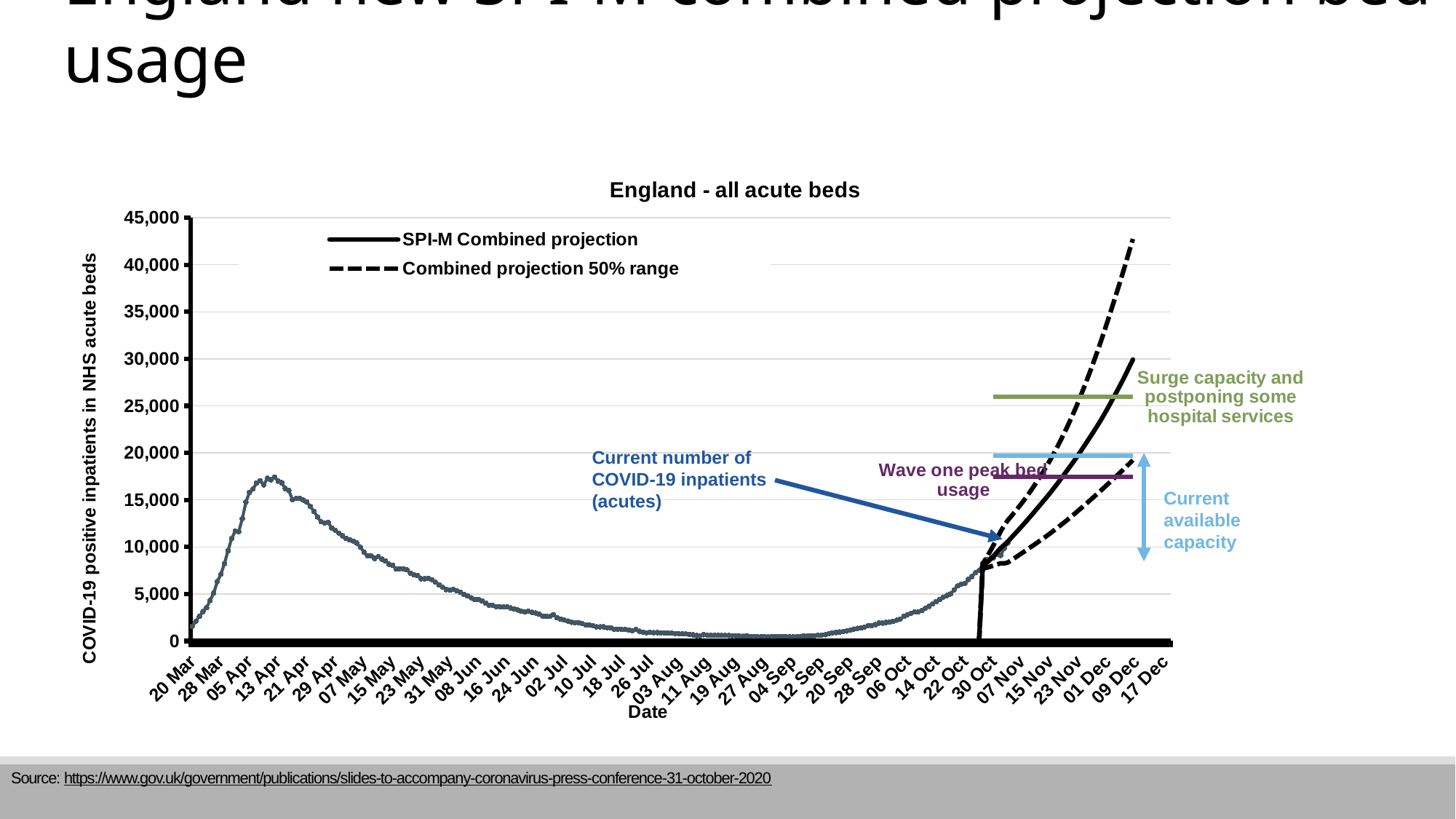
Is the peak of the inpatient line in April greater or less than 15,000? greater How many series does the chart legend list? 2 Which is larger: the inpatient value at the April peak or the value at 30 Oct? The April peak What is the title of the chart? England - all acute beds Is the number of inpatients in early August greater or less than 5,000? less What is the label of the y axis? COVID-19 positive inpatients in NHS acute beds What kind of chart is shown on the slide? Line chart Is the peak of the inpatient line in April greater or less than 20,000? less Does the inpatient line rise or fall between mid-April and the end of August? Falls Does the inpatient line rise or fall between early September and 30 Oct? Rises